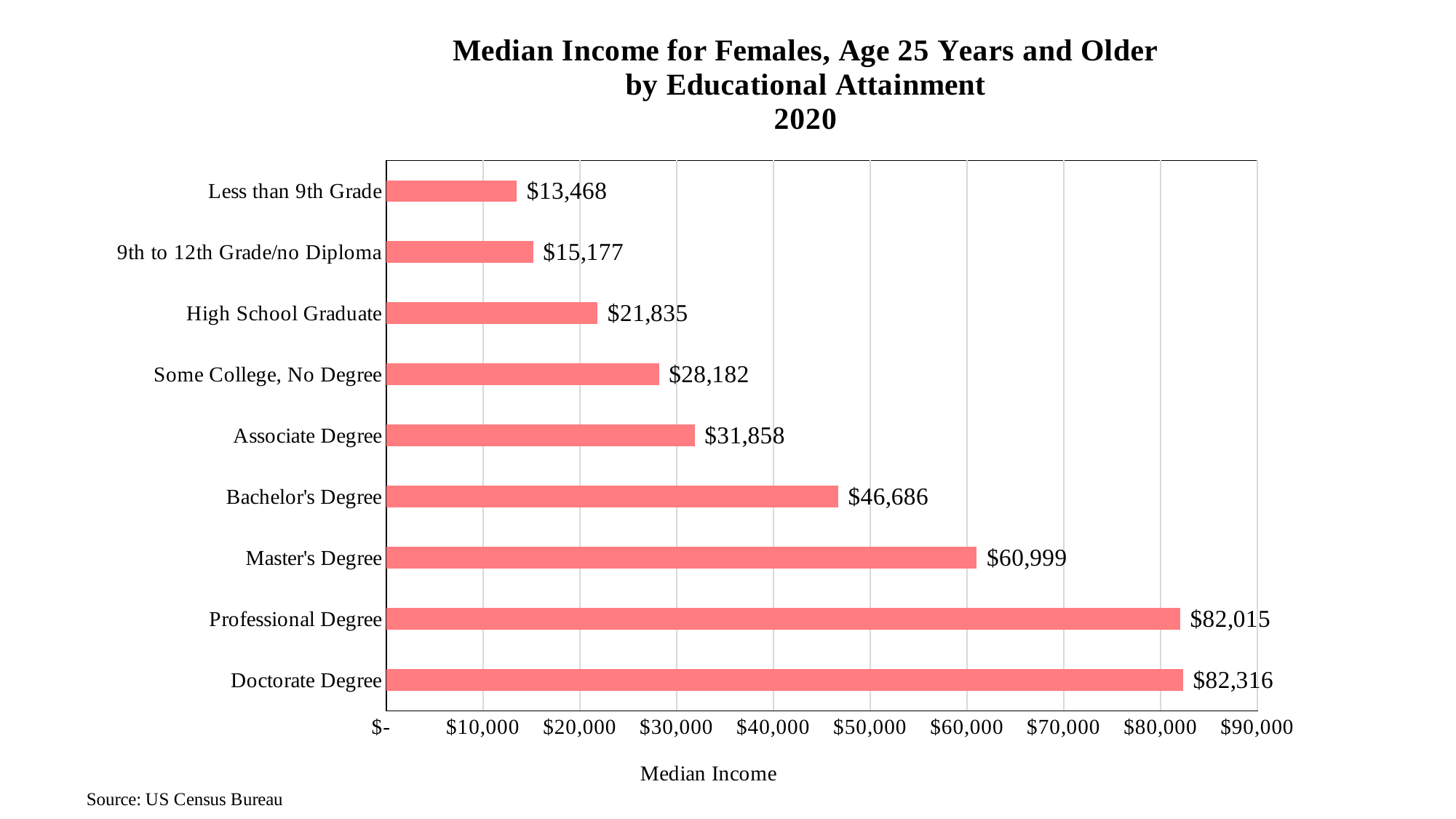
Which has a higher median income: Associate Degree or Some College, No Degree? Associate Degree How many educational attainment categories are shown in the chart? 9 Is the median income for a Bachelor's Degree greater or less than $50,000? less What is the median income for females with Some College, No Degree? $28,182 What is the difference in median income between an Associate Degree and a High School Graduate? $10,023 Which educational attainment category has the lowest median income? Less than 9th Grade What is the difference in median income between a Master's Degree and a Bachelor's Degree? $14,313 What is the label of the horizontal axis? Median Income What is the median income for females with a Bachelor's Degree? $46,686 What is the median income for females with a Master's Degree? $60,999 What type of chart is shown on the slide? bar chart What is the median income for females with a High School Graduate level of education? $21,835